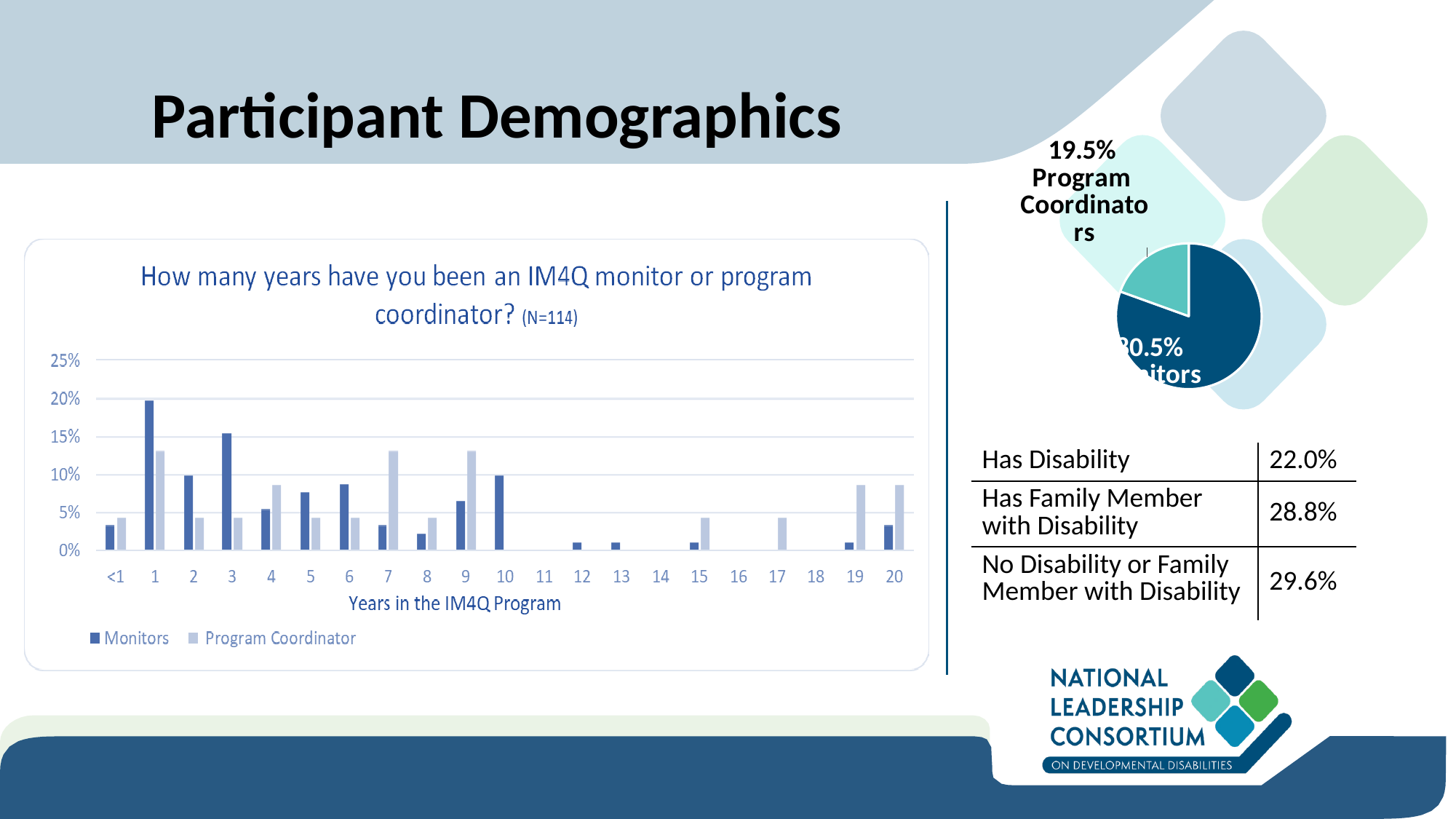
In the bar chart on the left, at which number of years is the Monitors value highest? 1 In the bar chart on the left, which series has the larger value at 1 year, Monitors or Program Coordinator? Monitors How many year categories are shown on the x axis of the bar chart on the left? 21 In the bar chart on the left, is the Monitors value for 8 years greater or less than 5%? less In the bar chart on the left, which series has the larger value at 7 years, Monitors or Program Coordinator? Program Coordinator What kind of chart is the chart titled "How many years have you been an IM4Q monitor or program coordinator?"? bar chart How many series does the legend of the bar chart on the left list? 2 In the bar chart on the left, is the Monitors value for 1 year greater or less than 15%? greater In the pie chart on the right, what share of participants are Program Coordinators? 19.5% In the pie chart on the right, which slice is larger, Monitors or Program Coordinators? Monitors In the bar chart on the left, is the Program Coordinator value for 7 years greater or less than 10%? greater What is the sample size (N) shown in the title of the bar chart on the left? N=114